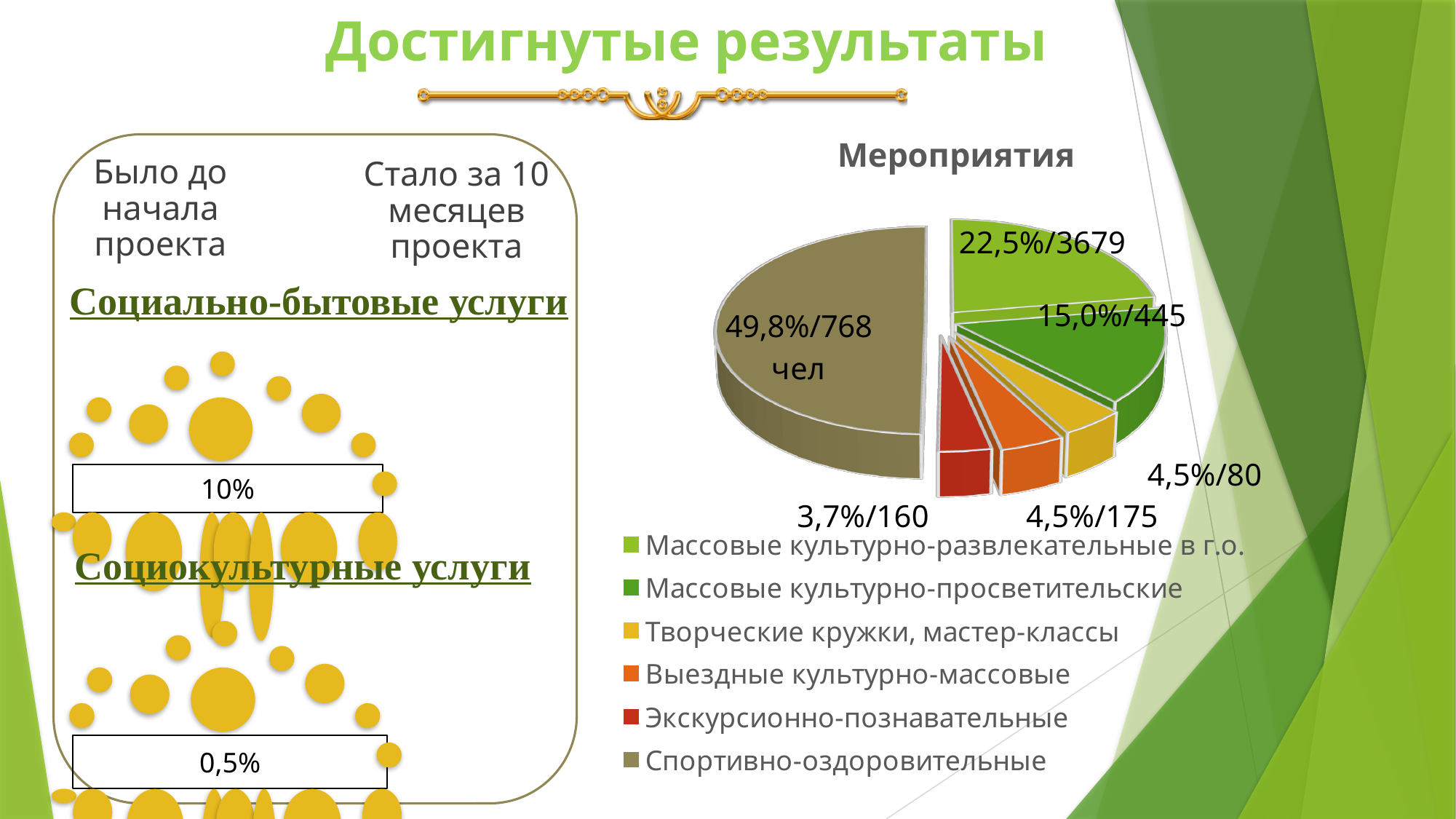
In the "Мероприятия" pie chart, what percentage share does "Выездные культурно-массовые" have? 4,5% What kind of chart is shown under the title "Мероприятия"? pie chart In the "Мероприятия" pie chart, which category has the smallest share? Экскурсионно-познавательные How many slices does the "Мероприятия" pie chart have? 6 In the "Мероприятия" pie chart, which has the larger share: "Массовые культурно-развлекательные в г.о." or "Массовые культурно-просветительские"? Массовые культурно-развлекательные в г.о. In the "Мероприятия" pie chart, what is the data label for "Спортивно-оздоровительные"? 49,8%/768 чел What is the title of the pie chart on the right of the slide? Мероприятия In the "Мероприятия" pie chart, what is the data label for "Массовые культурно-развлекательные в г.о."? 22,5%/3679 In the "Мероприятия" pie chart, what is the data label for "Экскурсионно-познавательные"? 3,7%/160 In the "Мероприятия" pie chart, which category has the largest share? Спортивно-оздоровительные In the "Мероприятия" pie chart, what is the data label for "Массовые культурно-просветительские"? 15,0%/445 How many entries does the legend of the "Мероприятия" pie chart list? 6